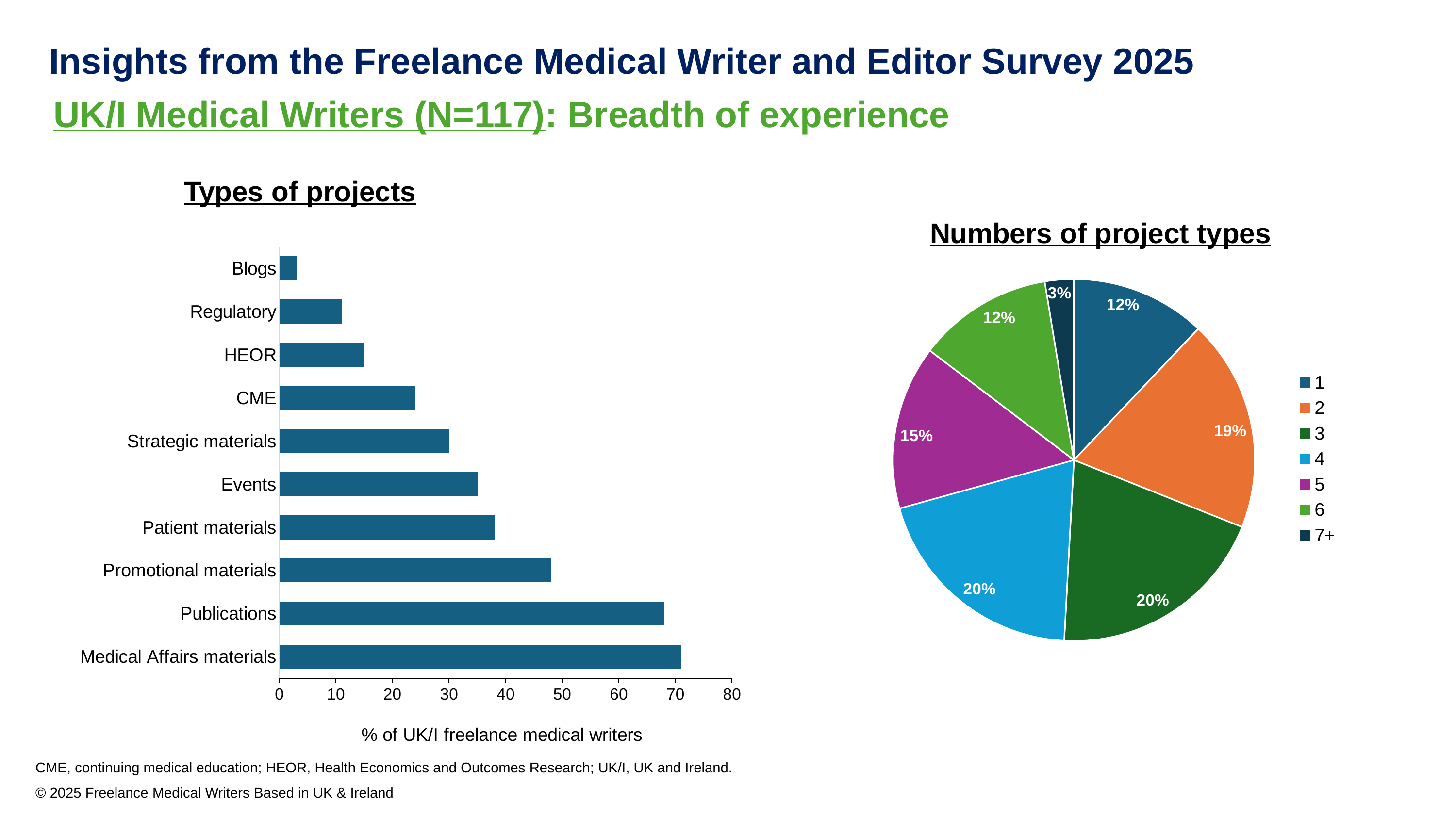
What kind of chart is the 'Types of projects' chart? bar chart In the 'Numbers of project types' pie chart, what is the difference between the share for '2' and the share for '5'? 4% In the 'Types of projects' chart, is the value for Regulatory greater or less than 20? less In the 'Numbers of project types' pie chart, what share is labelled for the '2' slice? 19% In the 'Types of projects' chart, which project type has the highest percentage of UK/I freelance medical writers? Medical Affairs materials In the 'Types of projects' chart, is the value for Promotional materials greater or less than 40? greater In the 'Types of projects' chart, is the value for Publications greater or less than 60? greater In the 'Types of projects' chart, which is larger: the value for CME or the value for Events? Events How many entries does the legend of the 'Numbers of project types' pie chart list? 7 In the 'Types of projects' chart, which project type has the lowest percentage? Blogs How many project types are shown in the 'Types of projects' chart? 10 In the 'Numbers of project types' pie chart, which category has the smallest share? 7+